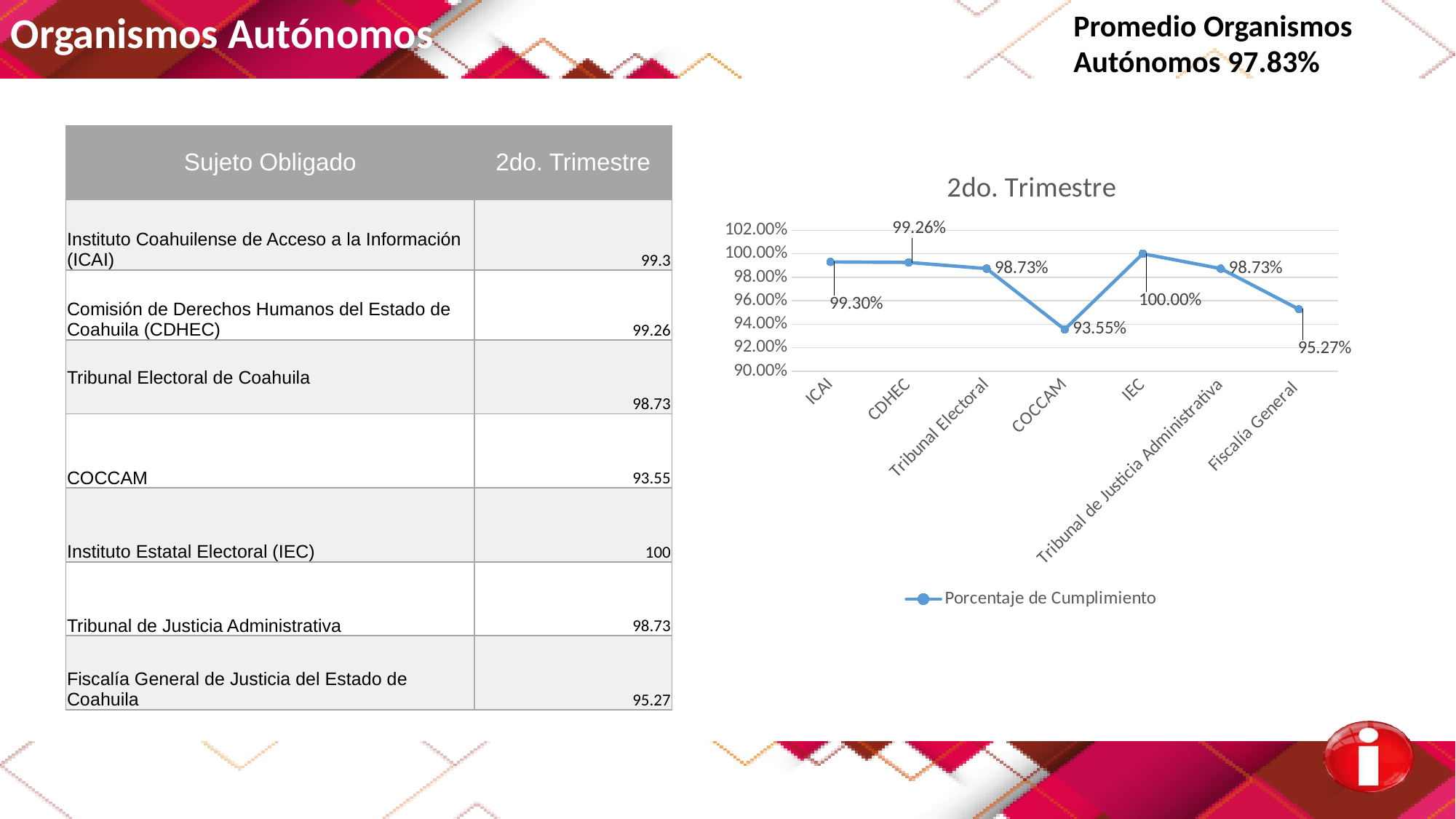
What is the value for ICAI in the chart? 99.30% Which category has the highest value in the chart? IEC Is the value for COCCAM greater or less than 96.00%? less What is the difference between the values for IEC and COCCAM? 6.45% What is the value for COCCAM in the chart? 93.55% How many categories are plotted on the x axis of the chart? 7 How many series does the chart legend list? 1 What is the title of the chart? 2do. Trimestre What kind of chart is shown on the slide? line chart Which is larger, the value for CDHEC or the value for Fiscalía General? CDHEC Which category has the lowest value in the chart? COCCAM What is the value for Fiscalía General in the chart? 95.27%